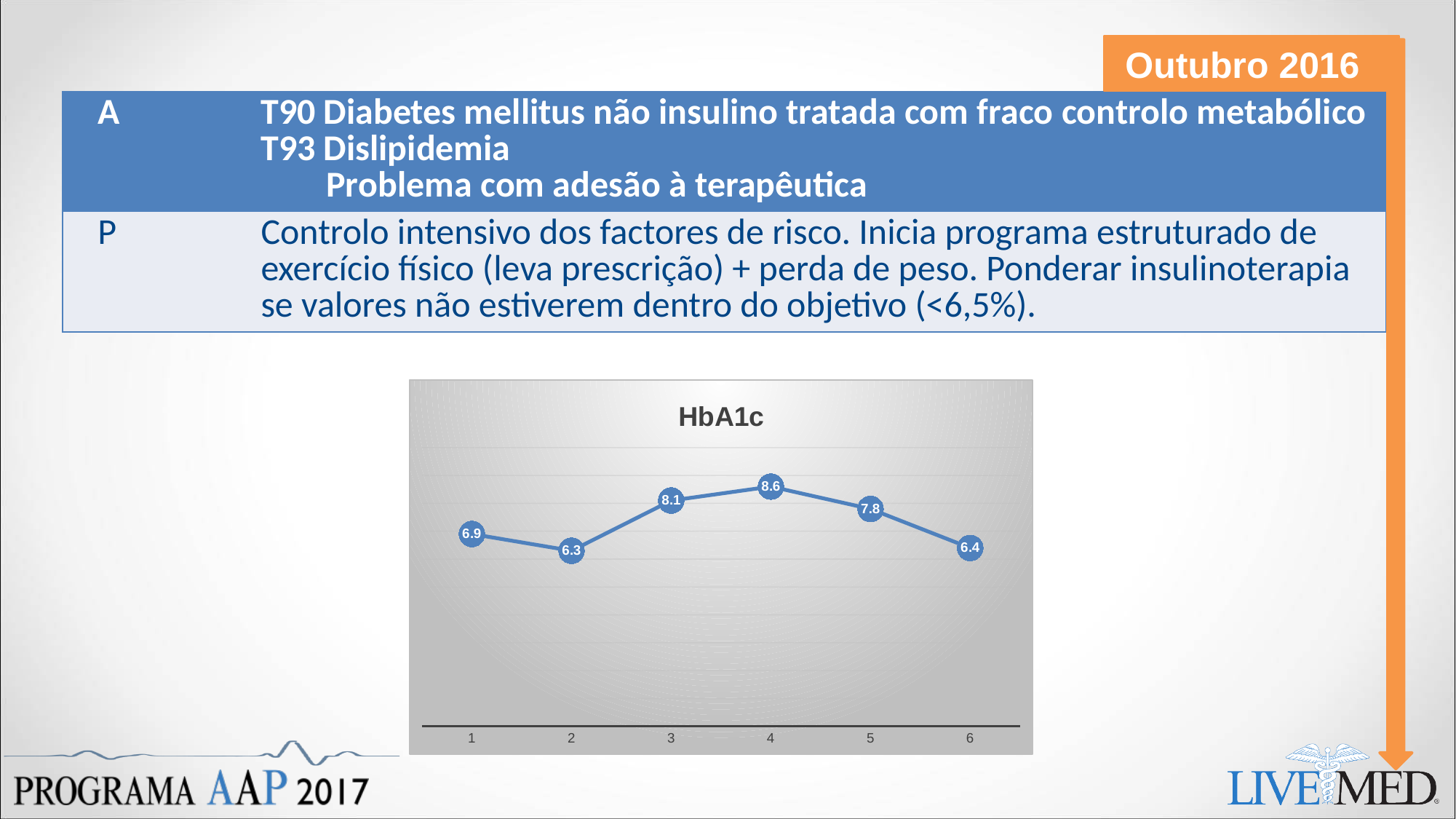
What is the difference between the HbA1c values at point 4 and point 2? 2.3 What is the difference between the HbA1c values at point 1 and point 6? 0.5 What is the HbA1c value at point 6? 6.4 At which point is the HbA1c value highest? 4 Which has a larger HbA1c value, point 3 or point 5? point 3 At which point is the HbA1c value lowest? 2 What is the HbA1c value at point 1? 6.9 How many data points are plotted on the HbA1c chart? 6 What is the title of the chart? HbA1c What kind of chart is shown on the slide? line chart Does the HbA1c value rise or fall from point 4 to point 6? fall What is the HbA1c value at point 4? 8.6